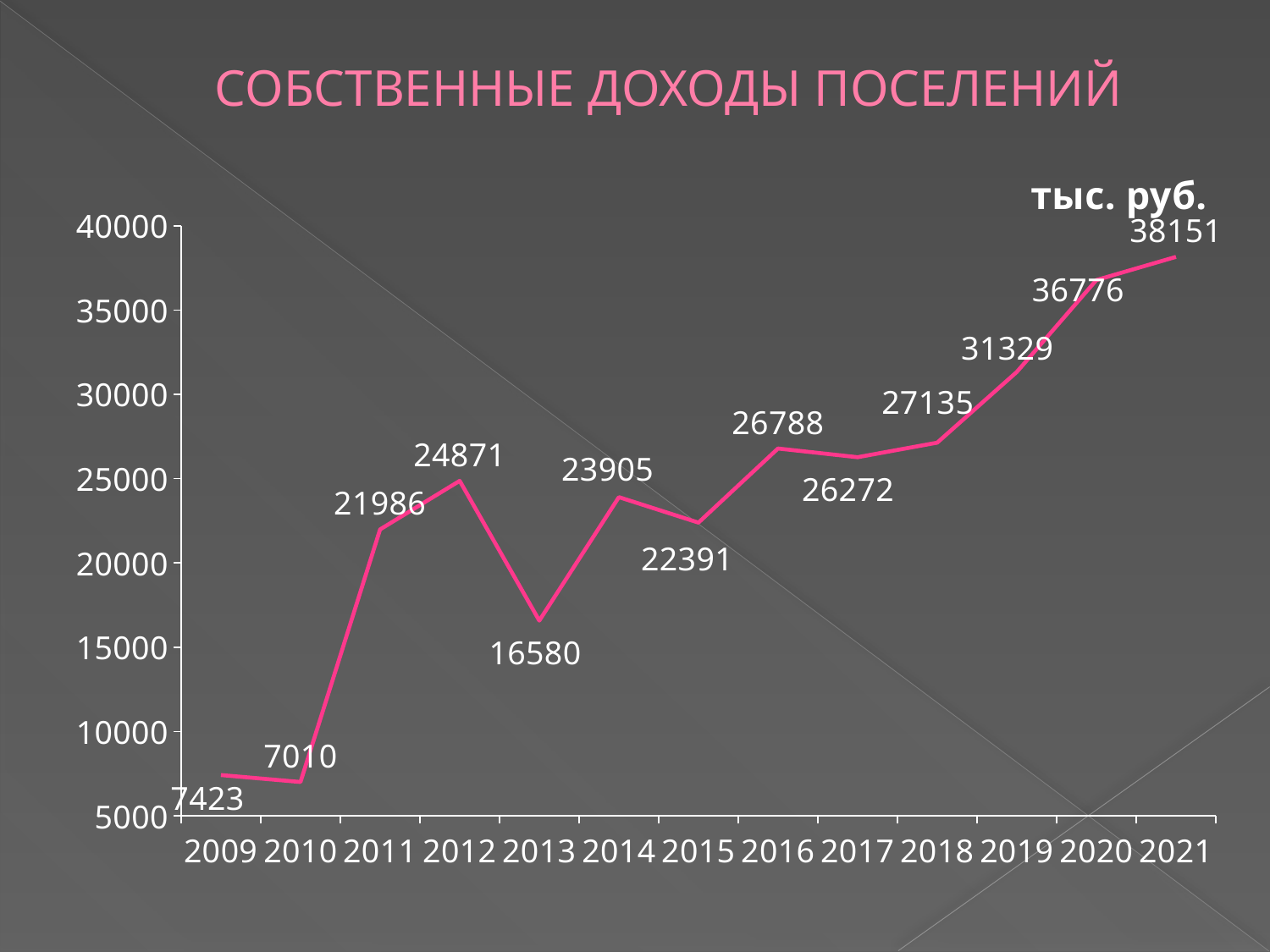
What is the value for 2019? 31329 What is the difference between the values for 2012 and 2013? 8291 What is the value for 2013? 16580 What unit is indicated for the values on the chart? тыс. руб. Is the value for 2013 greater or less than 20000? less What is the value for 2009? 7423 What is the difference between the values for 2021 and 2020? 1375 Which year has the lowest value? 2010 What type of chart is shown on the slide? line chart How many years are plotted on the chart? 13 Which is larger, the value for 2016 or the value for 2017? 2016 Which year has the highest value? 2021